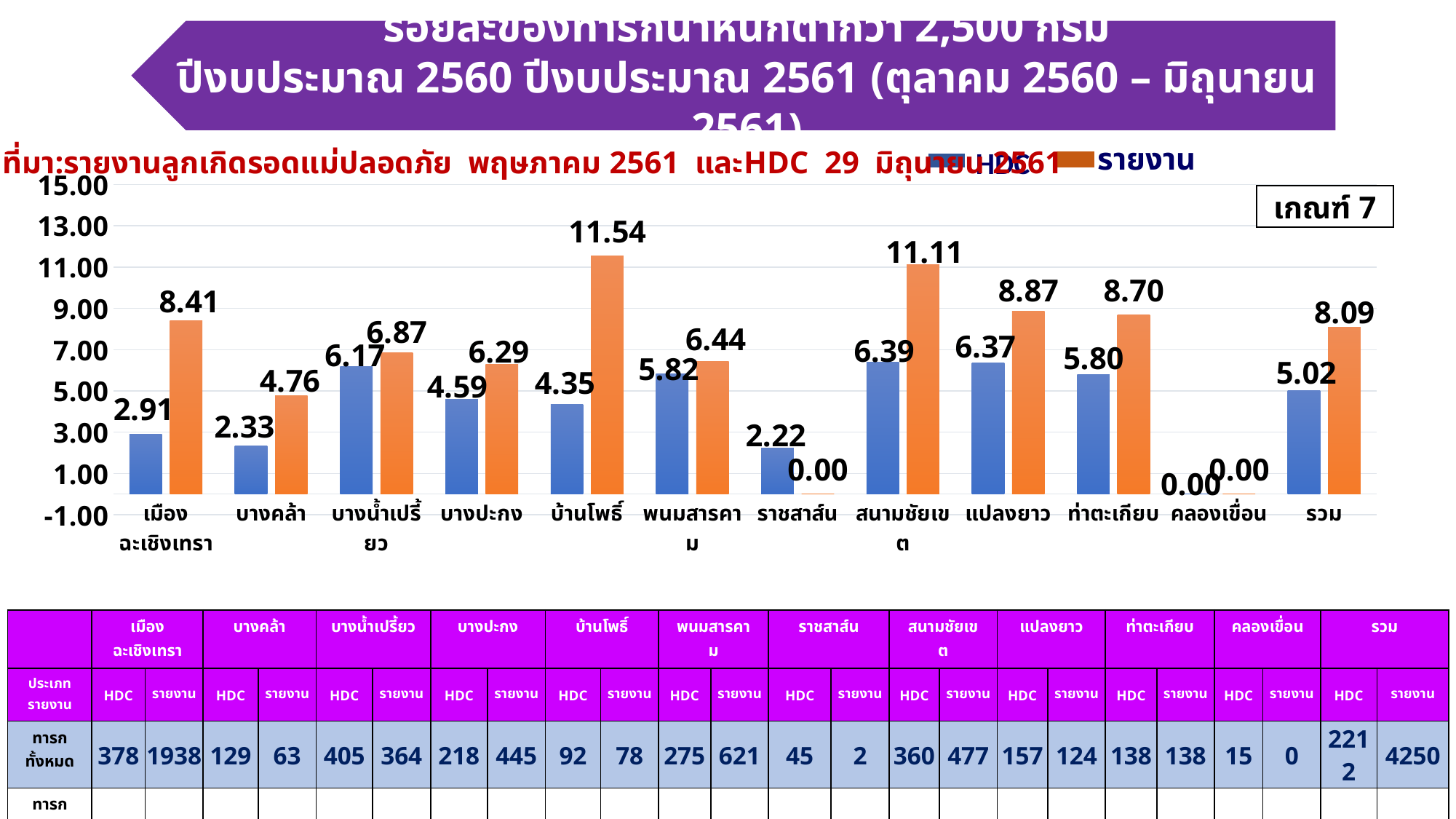
How many series does the chart legend list? 2 Which category has the lowest HDC value? คลองเขื่อน Which category has the highest รายงาน value? บ้านโพธิ์ What is the รายงาน value for รวม? 8.09 Is the รายงาน value for ท่าตะเกียบ greater or less than 7.00? greater How many categories are shown on the x axis of the chart? 12 What colour are the HDC bars in the chart? blue What is the รายงาน value for สนามชัยเขต? 11.11 What is the difference between the รายงาน and HDC values for เมืองฉะเชิงเทรา? 5.50 What is the HDC value for บ้านโพธิ์? 4.35 What kind of chart is shown on the slide? bar chart Which is larger for ราชสาส์น, the HDC value or the รายงาน value? HDC